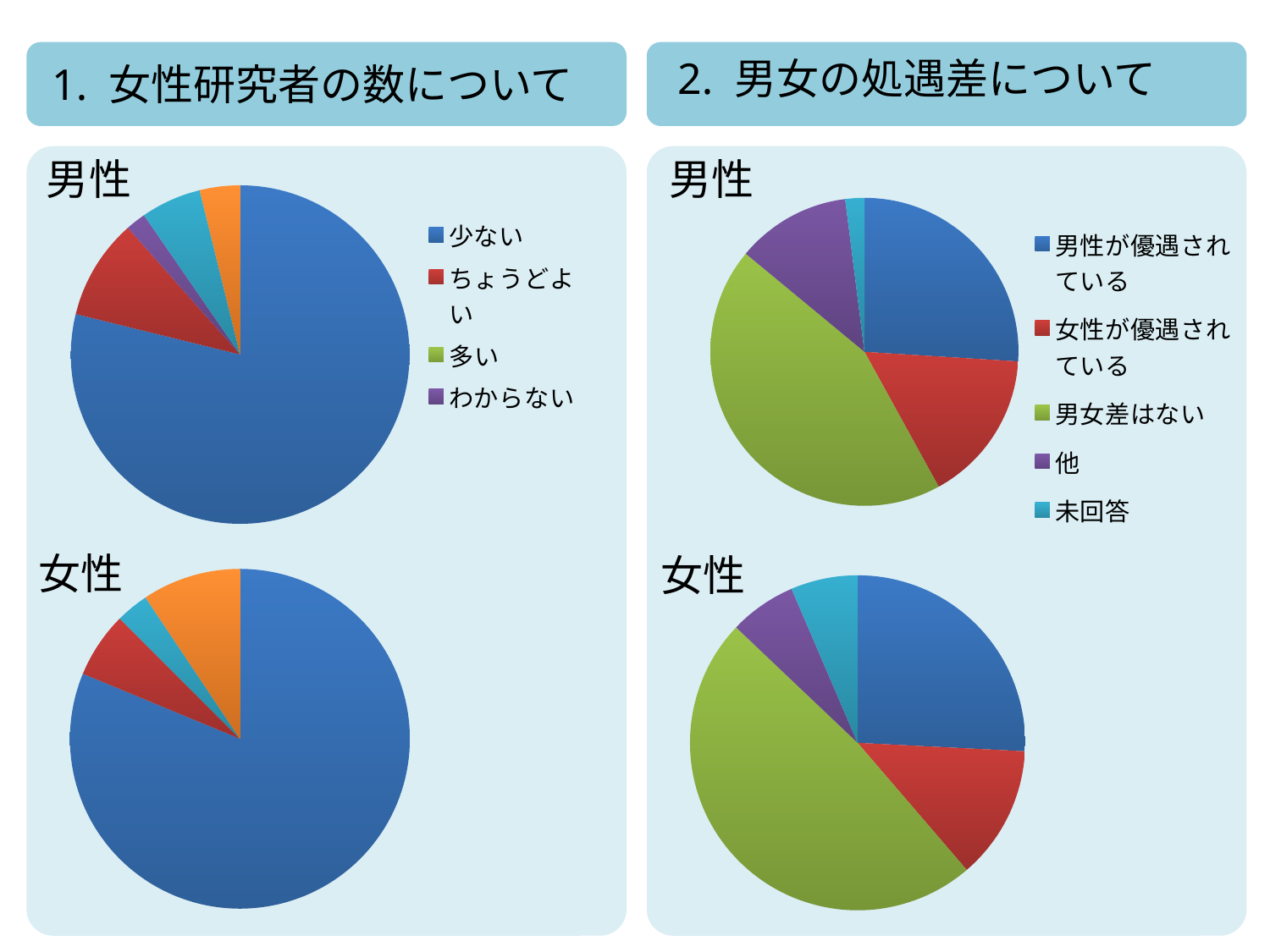
In the 男性 pie chart under 2. 男女の処遇差について, which category has the smallest slice? 未回答 In the 男性 pie chart under 1. 女性研究者の数について, which slice is larger: 少ない or ちょうどよい? 少ない How many slices does the 女性 pie chart under 2. 男女の処遇差について have? 5 In the 男性 pie chart under 1. 女性研究者の数について, which category has the smallest slice? わからない In the 男性 pie chart under 1. 女性研究者の数について, which category has the largest slice? 少ない How many entries does the legend under 2. 男女の処遇差について list? 5 In the 男性 pie chart under 2. 男女の処遇差について, which category has the largest slice? 男女差はない How many entries does the legend under 1. 女性研究者の数について list? 4 In the 女性 pie chart under 2. 男女の処遇差について, which slice is larger: 男性が優遇されている or 女性が優遇されている? 男性が優遇されている In the 女性 pie chart under 1. 女性研究者の数について, which category has the largest slice? 少ない What kind of chart is used for the 男性 chart under 1. 女性研究者の数について? pie chart